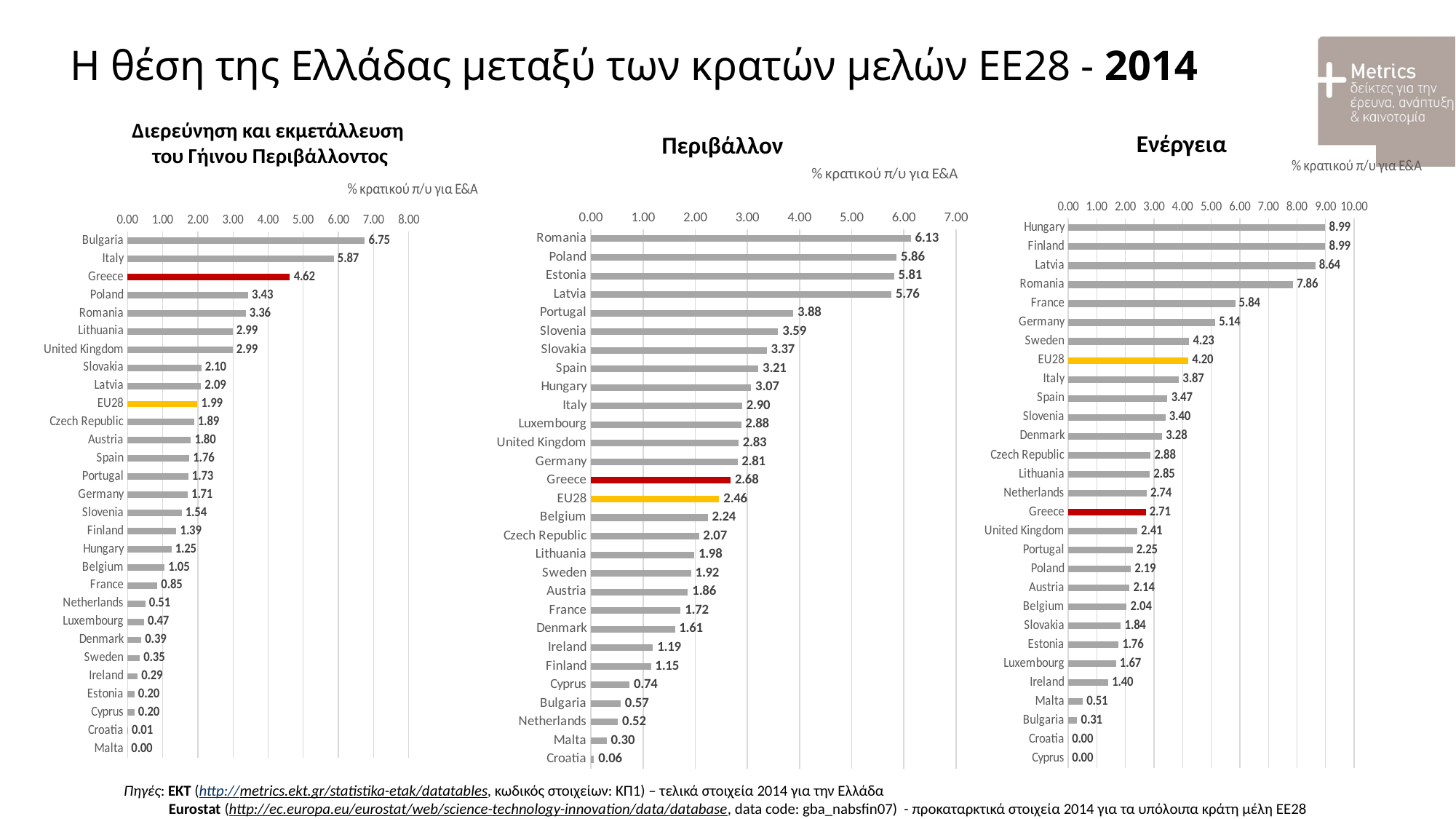
In the 'Περιβάλλον' chart, is the value for Portugal greater or less than 3.00? greater In the 'Ενέργεια' chart, what is the value for EU28? 4.20 In the 'Διερεύνηση και εκμετάλλευση του Γήινου Περιβάλλοντος' chart, what is the value for Poland? 3.43 In the 'Διερεύνηση και εκμετάλλευση του Γήινου Περιβάλλοντος' chart, what is the difference between Greece and EU28? 2.63 In the 'Ενέργεια' chart, what is the difference between EU28 and Greece? 1.49 In the 'Διερεύνηση και εκμετάλλευση του Γήινου Περιβάλλοντος' chart, which country has the lowest value? Malta What kind of chart is the 'Περιβάλλον' chart? bar chart In the 'Περιβάλλον' chart, which country has the highest value? Romania In the 'Ενέργεια' chart, which is larger, the value for Greece or the value for Netherlands? Netherlands In the 'Διερεύνηση και εκμετάλλευση του Γήινου Περιβάλλοντος' chart, what colour is the bar for Greece? red In the 'Περιβάλλον' chart, what is the value for Greece? 2.68 How many categories are shown in the 'Ενέργεια' chart? 29